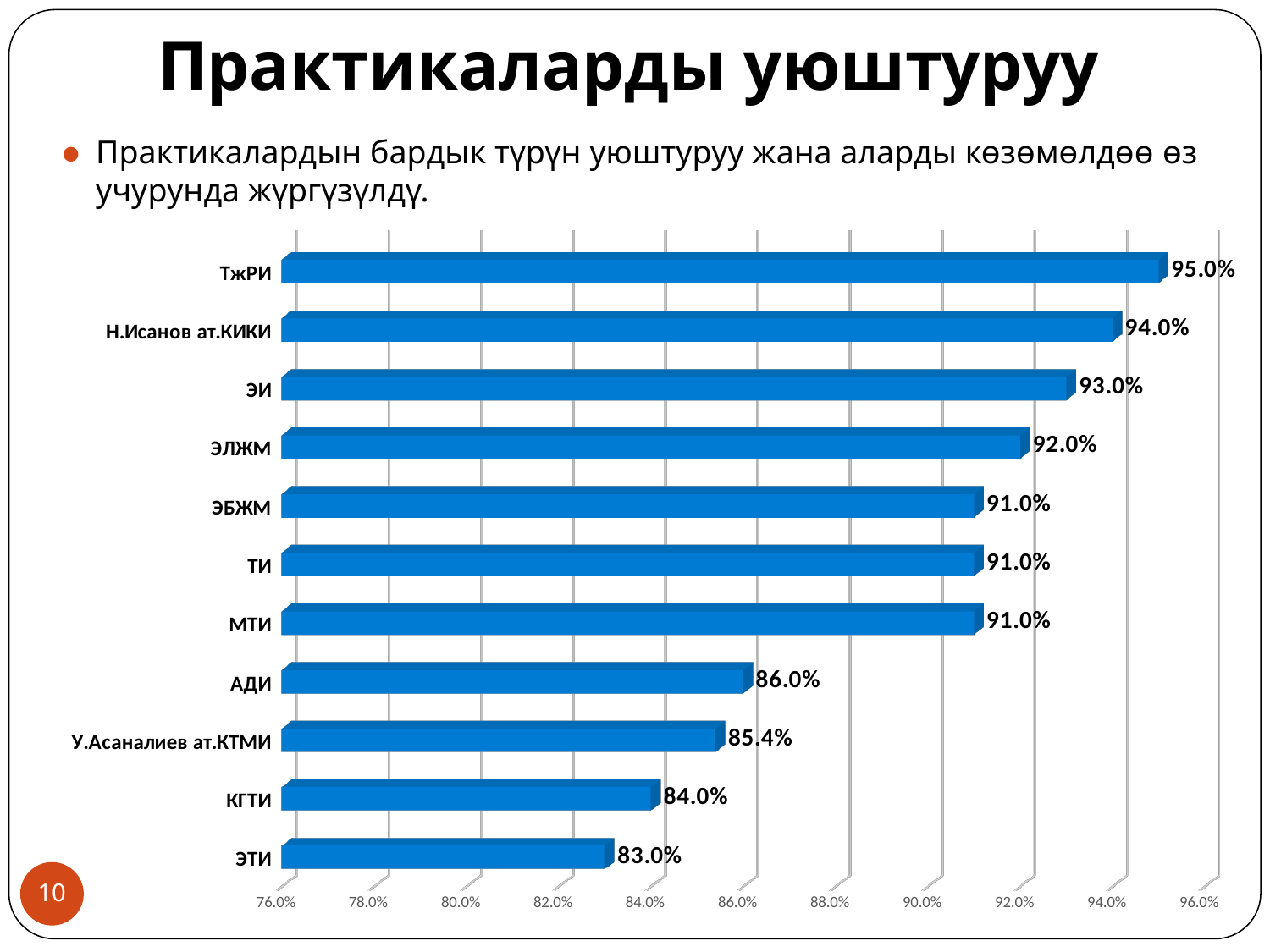
Which category has the lowest value? ЭТИ What is the value for ЭЛЖМ? 92.0% How many categories have a value of 91.0%? 3 How many categories are shown in the chart? 11 Is the value for Н.Исанов ат.КИКИ greater or less than 90.0%? greater What is the value for ТжРИ? 95.0% What kind of chart is shown on the slide? bar chart What is the difference between the values for ТжРИ and ЭТИ? 12.0% What is the difference between the values for АДИ and КГТИ? 2.0% What is the value for У.Асаналиев ат.КТМИ? 85.4% Which is larger, the value for ЭИ or the value for ЭБЖМ? ЭИ Which category has the highest value? ТжРИ